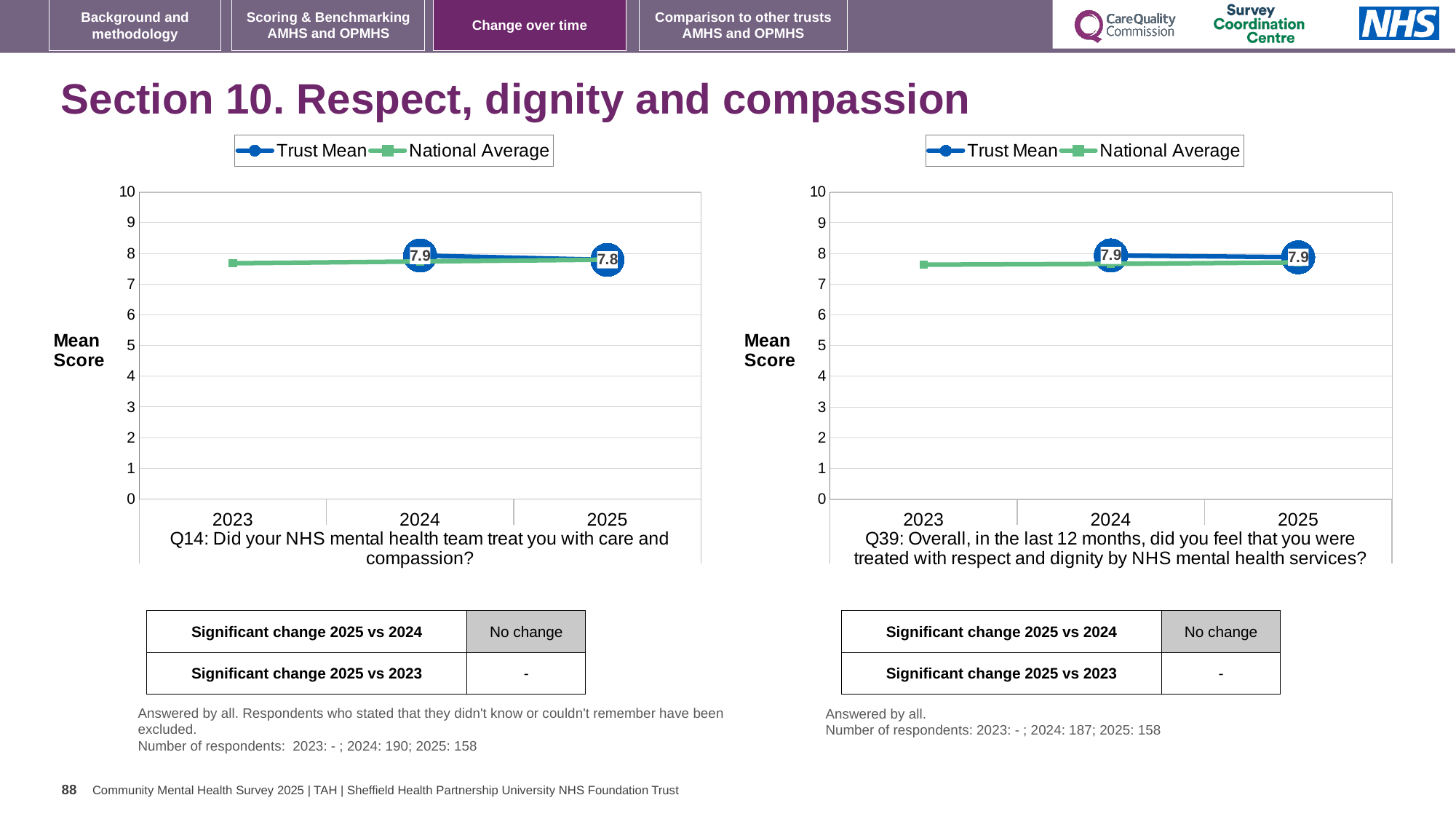
How many series does the legend of the Q14 chart on the left list? 2 How many years are shown on the x axis of the Q39 chart on the right? 3 In the Q39 chart on the right, what is the Trust Mean for 2024? 7.9 In the Q39 chart on the right, what is the Trust Mean for 2025? 7.9 In the Q14 chart on the left, is the National Average for 2023 greater or less than 7? greater In the Q14 chart on the left, does the Trust Mean rise or fall from 2024 to 2025? Fall In the Q14 chart on the left, what is the Trust Mean for 2024? 7.9 In the Q14 chart on the left, which year has the higher Trust Mean, 2024 or 2025? 2024 In the Q14 chart on the left, what is the Trust Mean for 2025? 7.8 What kind of chart is the Q39 chart on the right? Line chart In the Q39 chart on the right, is the National Average for 2023 greater or less than 8? less In the Q14 chart on the left, what is the difference between the Trust Mean for 2024 and for 2025? 0.1